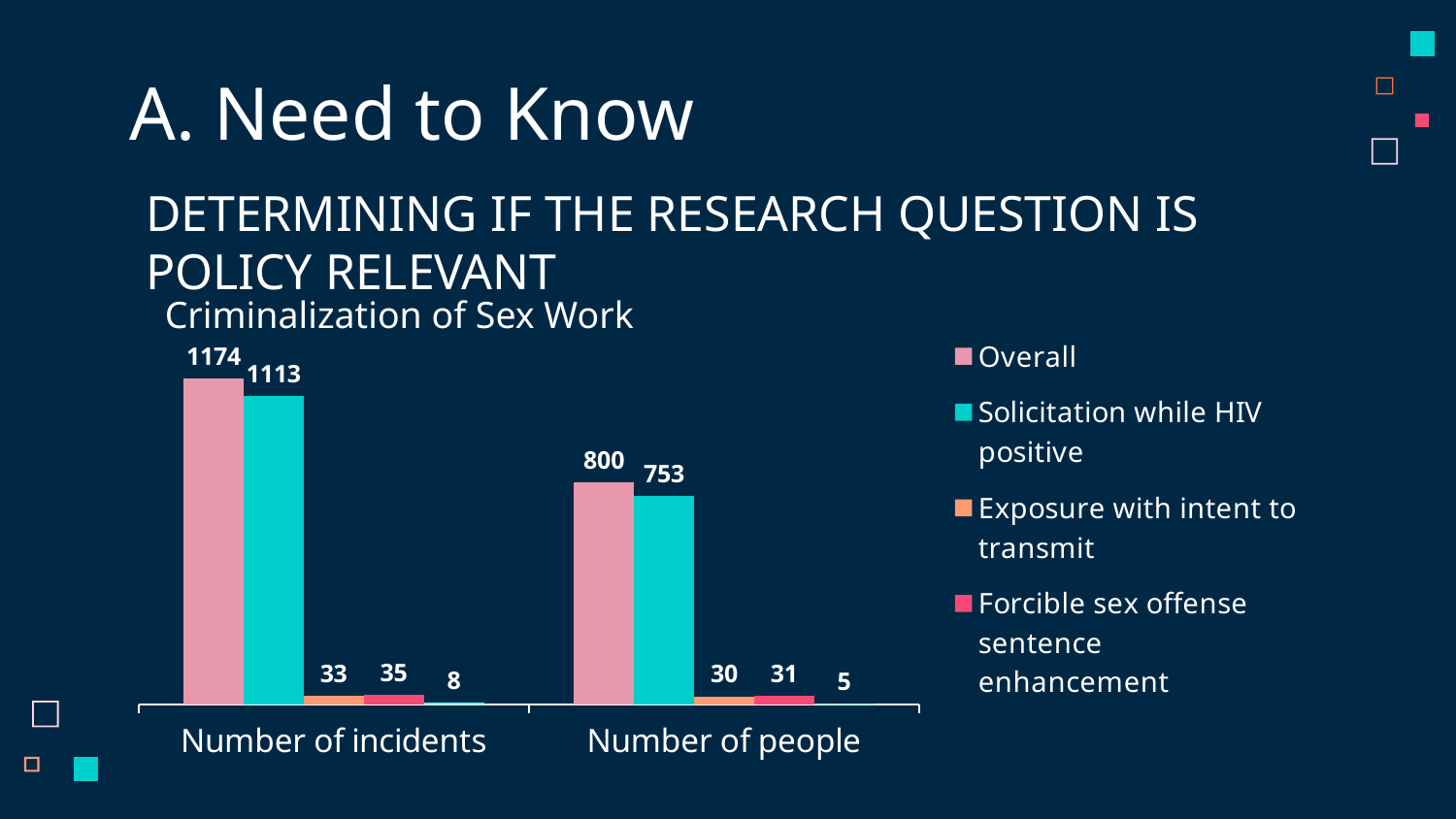
What is the difference between the Overall value for Number of incidents and the Overall value for Number of people? 374 For Number of people, what is the difference between the Overall value and the Solicitation while HIV positive value? 47 How many series does the chart legend list? 4 What is the value of the Forcible sex offense sentence enhancement series for Number of people? 31 What is the value of the Exposure with intent to transmit series for Number of incidents? 33 Which series has the highest value for Number of people? Overall What type of chart is shown on the slide? Bar chart How many categories are shown on the x axis of the chart? 2 What is the value of the Overall series for Number of incidents? 1174 For Number of incidents, what is the difference between the Overall value and the Solicitation while HIV positive value? 61 What is the value of the Solicitation while HIV positive series for Number of people? 753 For Number of incidents, which is larger: Exposure with intent to transmit or Forcible sex offense sentence enhancement? Forcible sex offense sentence enhancement